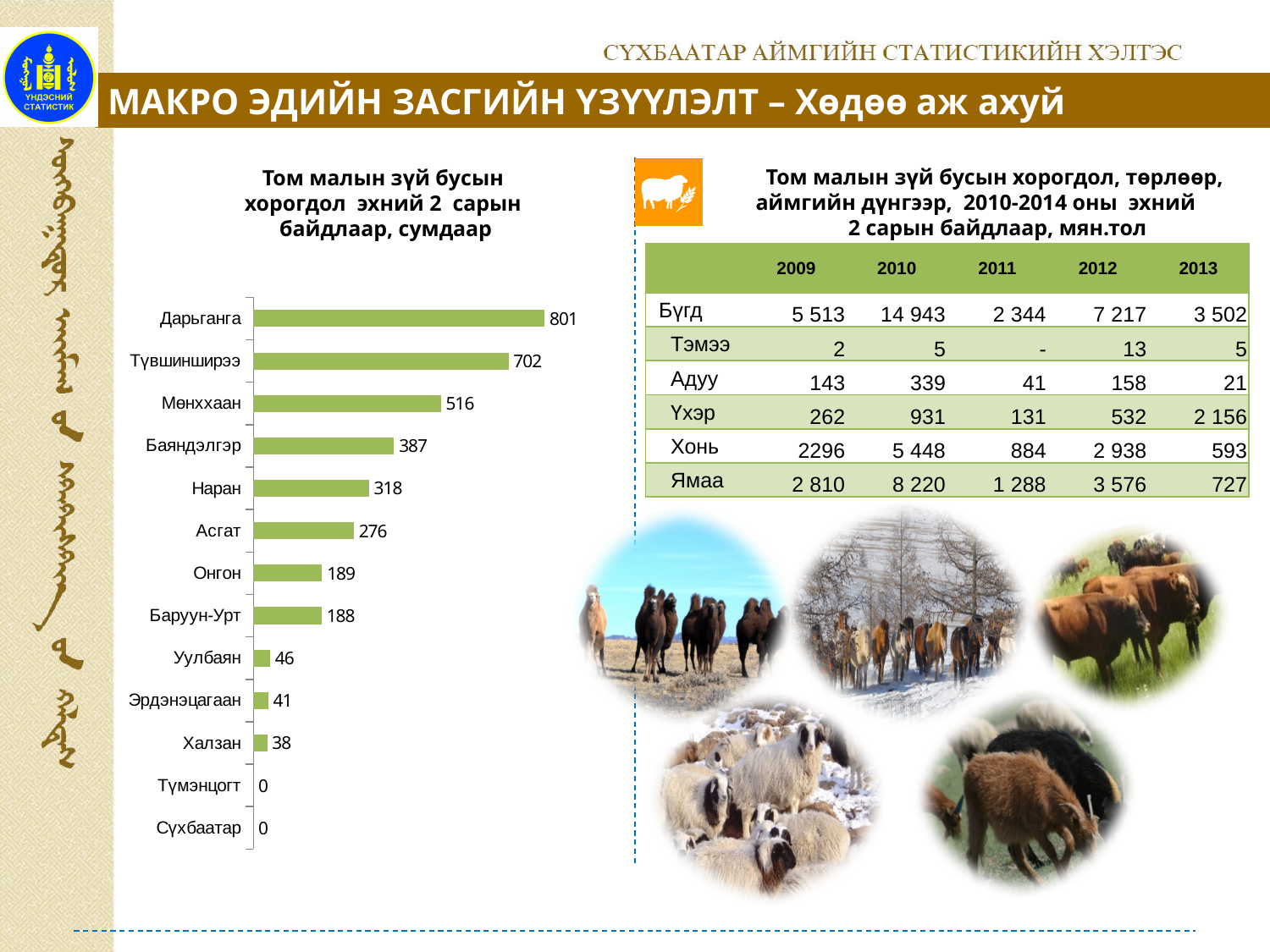
How many soums (categories) are shown in the bar chart? 13 Which has a larger value in the bar chart, Мөнххаан or Баяндэлгэр? Мөнххаан What is the value for Уулбаян in the bar chart? 46 How many soums in the bar chart have a value of 0? 2 What kind of chart is shown on the slide? bar chart What is the value for Наран in the bar chart? 318 Which soum has the highest value in the bar chart? Дарьганга What is the difference between the values for Баяндэлгэр and Асгат in the bar chart? 111 What is the difference between the values for Дарьганга and Түвшинширээ in the bar chart? 99 What is the value for Мөнххаан in the bar chart? 516 What is the value for Дарьганга in the bar chart? 801 What is the title of the bar chart? Том малын зүй бусын хорогдол эхний 2 сарын байдлаар, сумдаар